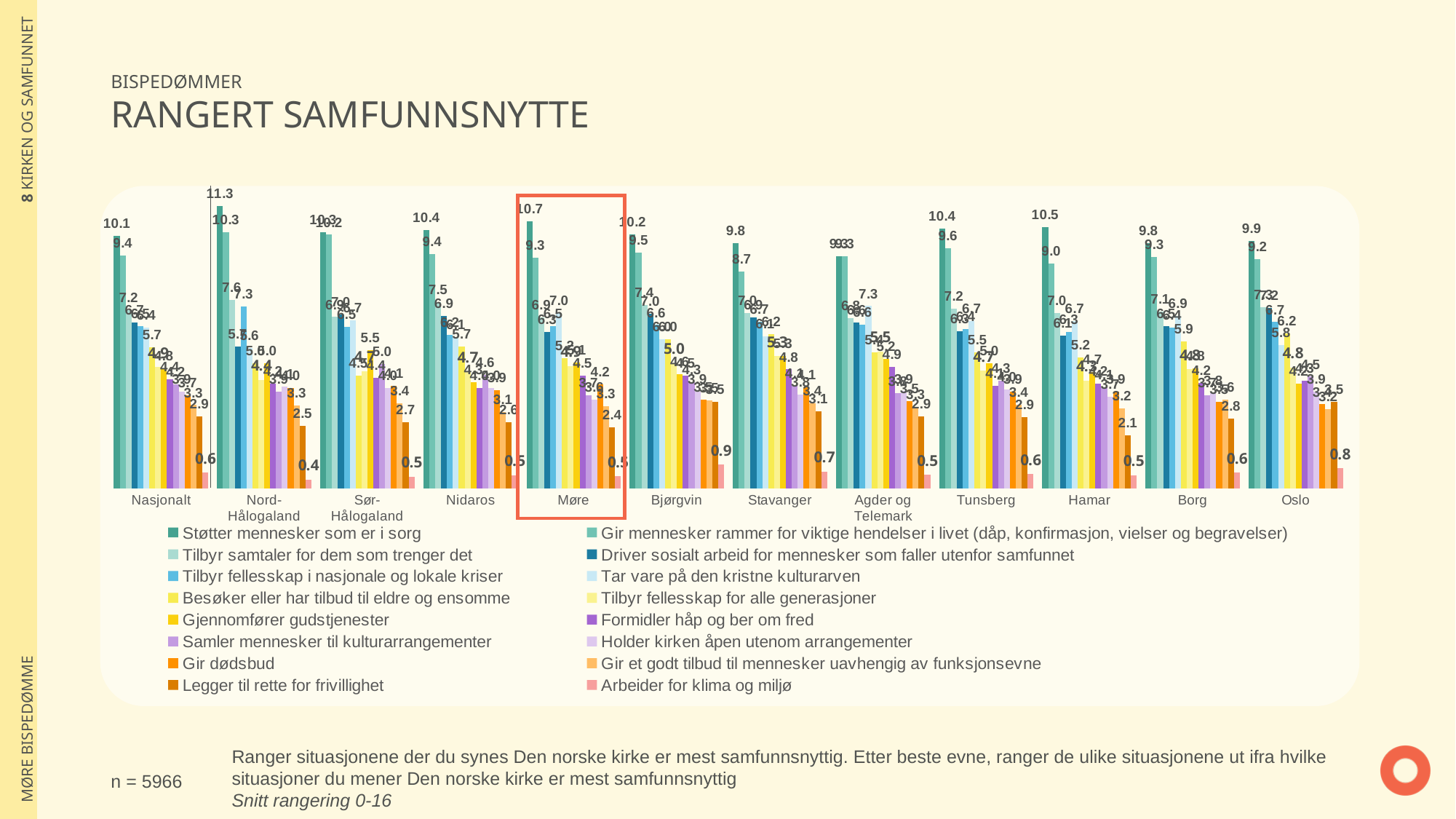
What is the value for 'Arbeider for klima og miljø' in Bjørgvin? 0.9 How many categories (bispedømmer including Nasjonalt) are shown along the x axis? 12 Which category has the highest value for 'Støtter mennesker som er i sorg'? Nord-Hålogaland What kind of chart is shown on the slide? bar chart Which has the higher value for 'Støtter mennesker som er i sorg', Hamar or Borg? Hamar How many series does the legend list? 16 Which category on the chart is highlighted with a red outline box? Møre What is the difference between the 'Støtter mennesker som er i sorg' values for Nord-Hålogaland (11.3) and Nasjonalt (10.1)? 1.2 What is the value for 'Støtter mennesker som er i sorg' in Møre? 10.7 What is the value for 'Støtter mennesker som er i sorg' in Nord-Hålogaland? 11.3 Which category has the lowest value for 'Arbeider for klima og miljø'? Nord-Hålogaland What is the value for 'Legger til rette for frivillighet' in Hamar? 2.1